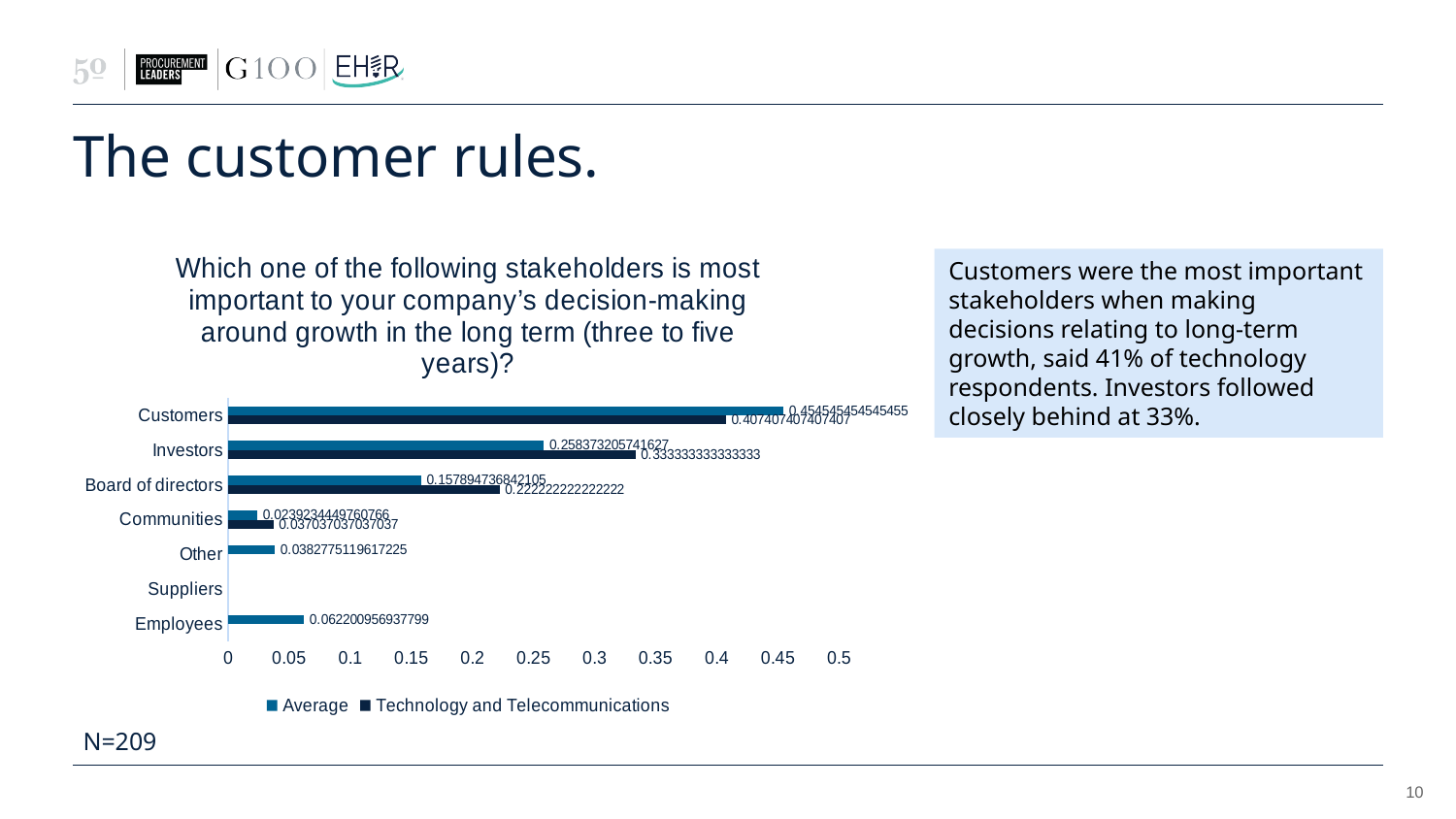
What is the Average value for Investors? 0.258373205741627 What is the Technology and Telecommunications value for Board of directors? 0.222222222222222 Is the Technology and Telecommunications value for Customers greater or less than 0.35? greater How many stakeholder categories are shown on the chart's vertical axis? 7 For Investors, which series has the larger value: Average or Technology and Telecommunications? Technology and Telecommunications Which stakeholder has the lowest Average value among those with a visible bar? Communities Which stakeholder has the highest Average value? Customers What kind of chart is shown on the slide? bar chart What are the two series named in the chart legend? Average; Technology and Telecommunications What is the Average value for Employees? 0.062200956937799 What is the Technology and Telecommunications value for Investors? 0.333333333333333 How many series does the chart legend list? 2